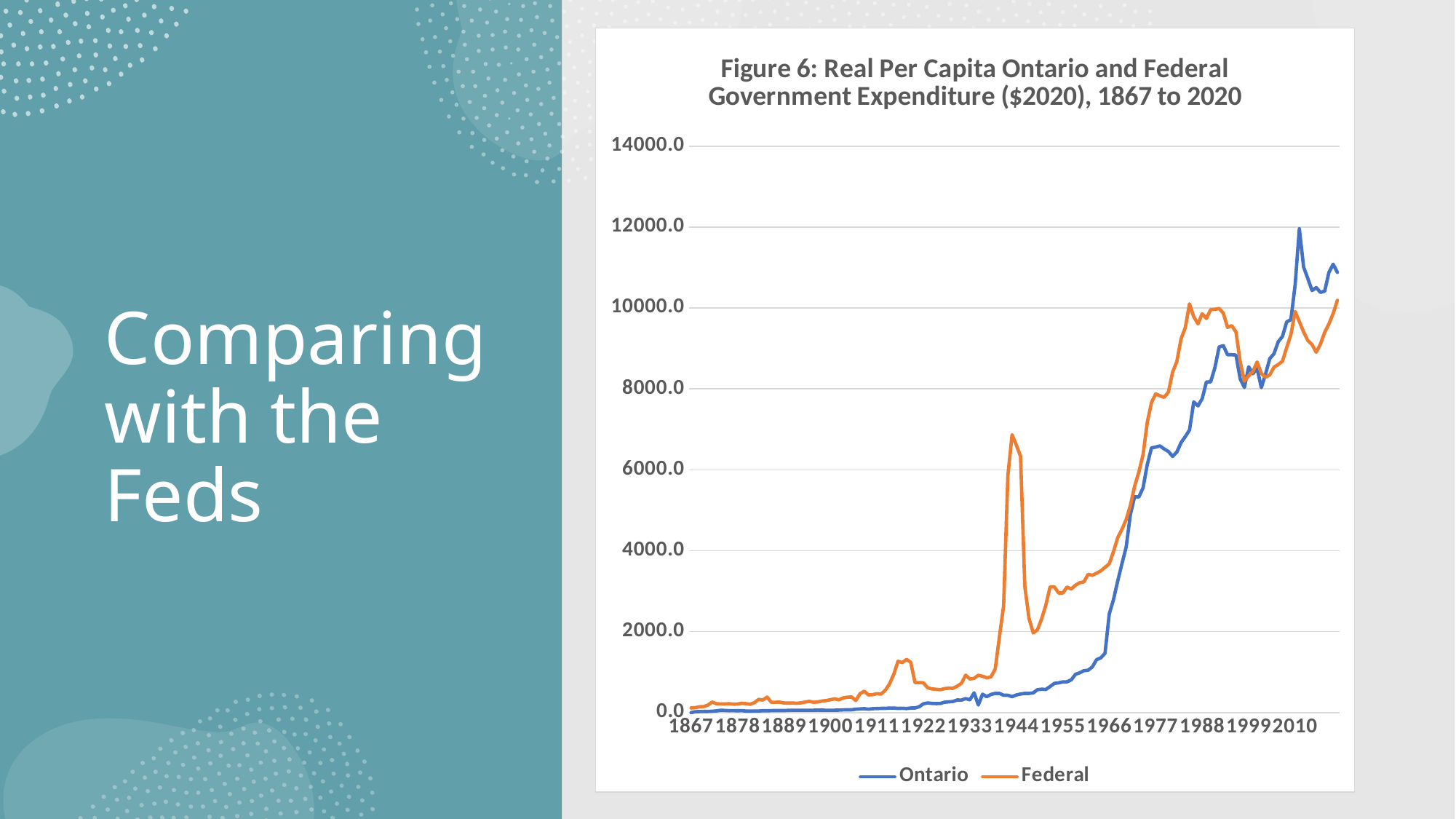
How many series does the legend list? 2 Is the peak value of the Federal series around 1944 greater or less than 6000.0? greater At the right end of the chart (2020), which series is higher, Ontario or Federal? Ontario Which colour is used for the Federal series? Orange What kind of chart is shown on the slide? Line chart Is the value for Ontario around 1944 greater or less than 2000.0? less Overall, does the Ontario series rise or fall from 1867 to 2020? Rise Is the value for Federal around 1955 greater or less than 2000.0? greater What is the title of the chart? Figure 6: Real Per Capita Ontario and Federal Government Expenditure ($2020), 1867 to 2020 Around 1944, which series has the higher value, Ontario or Federal? Federal How many year labels are shown on the x axis? 14 Which series reaches the highest value anywhere on the chart, Ontario or Federal? Ontario